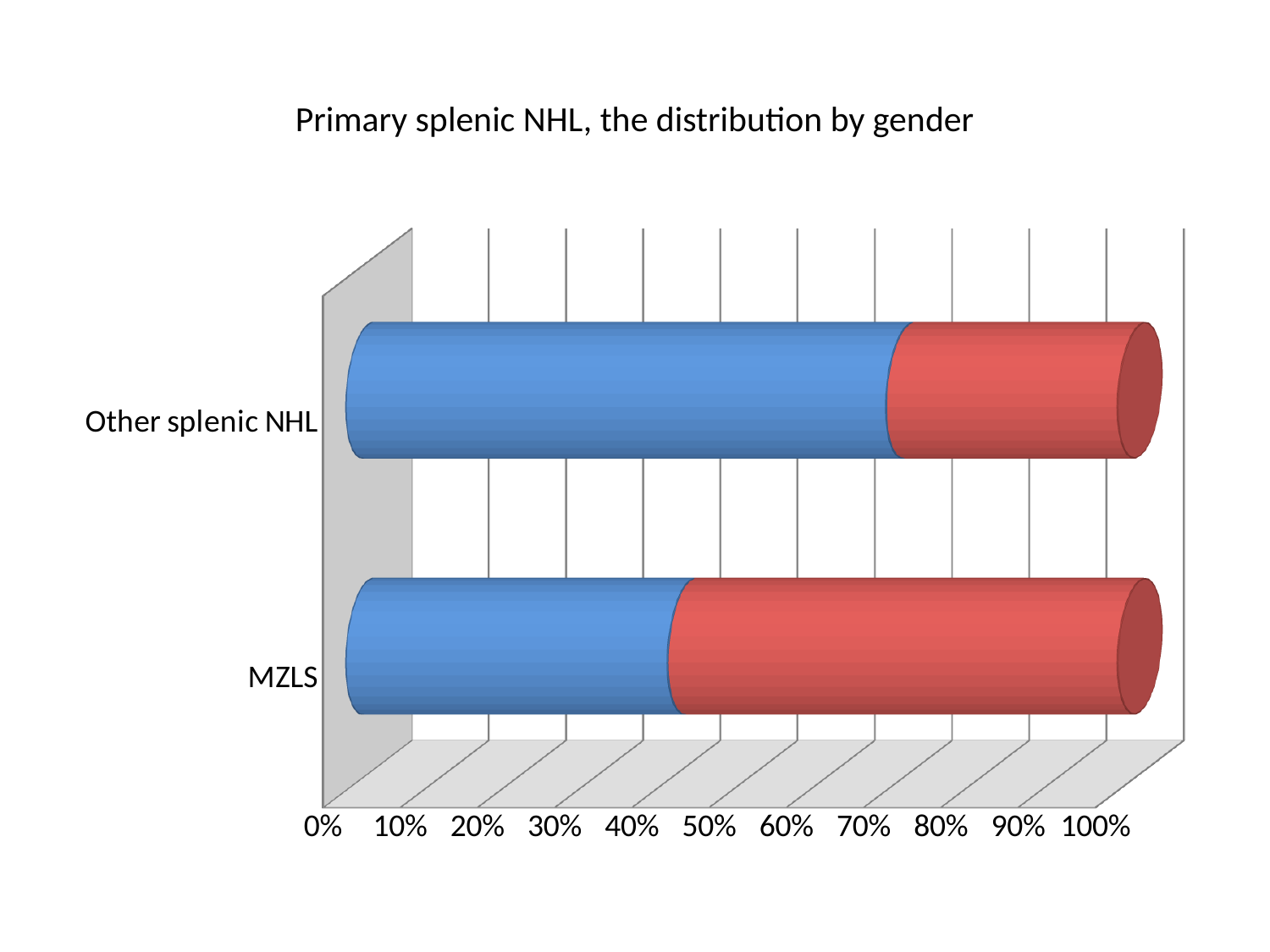
What kind of chart is shown on the slide? bar chart What is the title of the chart? Primary splenic NHL, the distribution by gender Is the blue segment for Other splenic NHL greater or less than 90%? less Which category has the smallest blue share? MZLS Which category has the larger red segment, Other splenic NHL or MZLS? MZLS Is the blue segment for MZLS greater or less than 30%? greater Is the blue segment for MZLS greater or less than 50%? less Which category has the larger blue segment, Other splenic NHL or MZLS? Other splenic NHL How many categories are shown on the chart? 2 What is the highest value shown on the horizontal axis? 100% Which two categories are shown on the chart? Other splenic NHL and MZLS